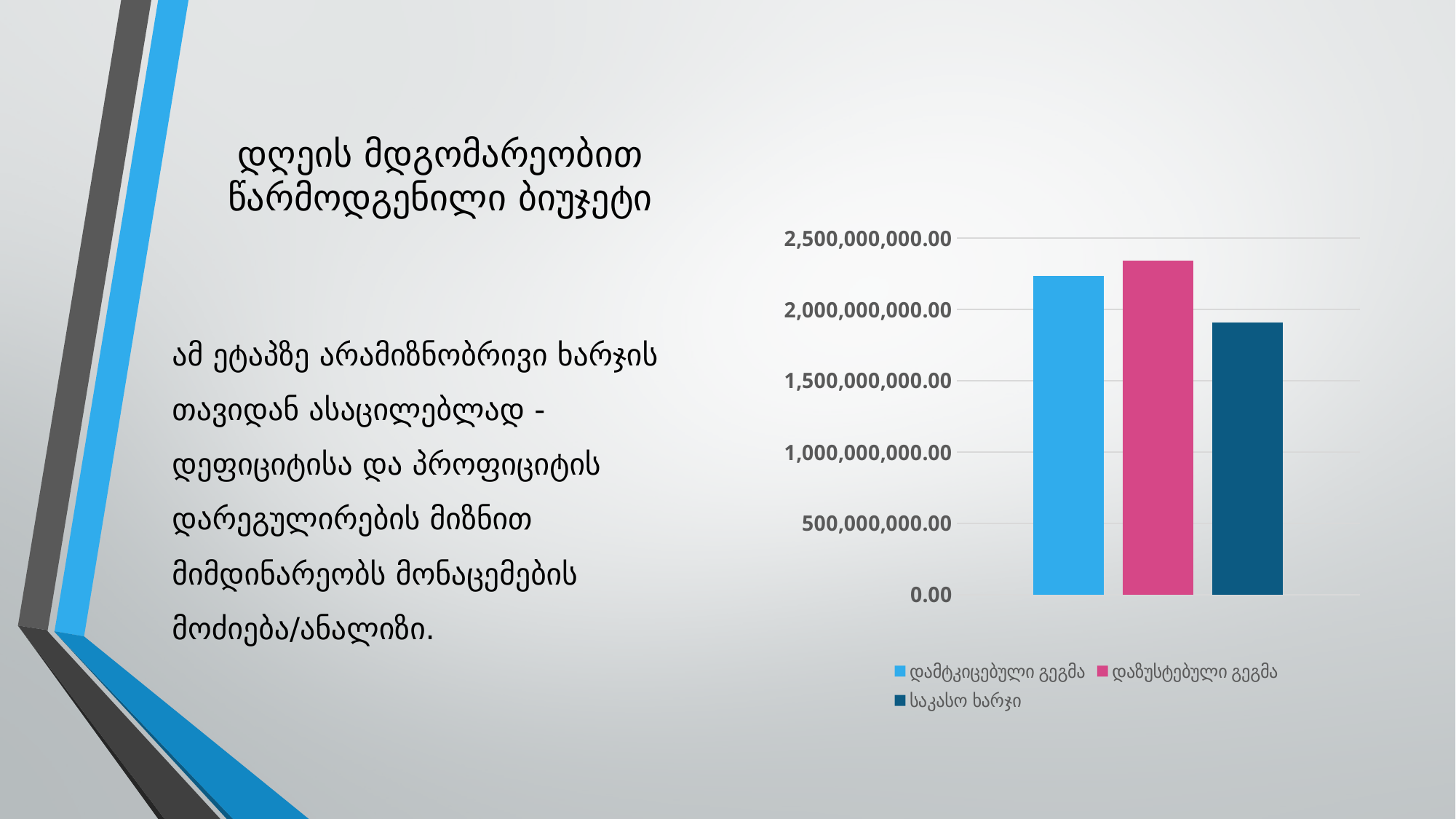
How many bars are plotted in the chart? 3 Is the value for საკასო ხარჯი greater or less than 2,000,000,000.00? less Which is larger, the bar for დამტკიცებული გეგმა or the bar for საკასო ხარჯი? დამტკიცებული გეგმა Is the value for დამტკიცებული გეგმა greater or less than 2,000,000,000.00? greater Which series has the highest bar in the chart? დაზუსტებული გეგმა Is the value for საკასო ხარჯი greater or less than 1,500,000,000.00? greater What colour is the bar for დაზუსტებული გეგმა? pink Which series has the lowest bar in the chart? საკასო ხარჯი What kind of chart is shown on the slide? bar chart How many series does the chart legend list? 3 What is the highest value shown on the chart's vertical axis? 2,500,000,000.00